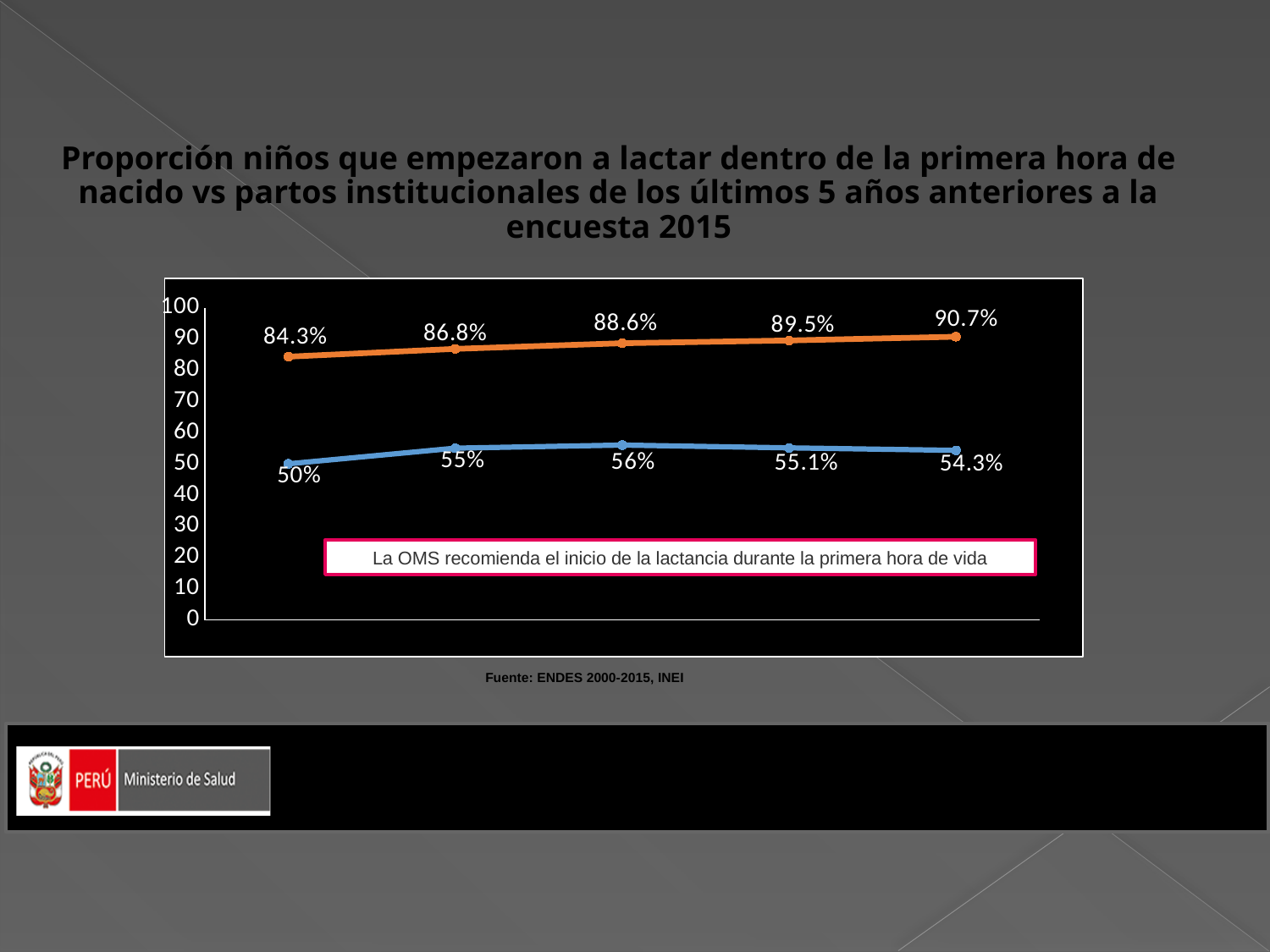
Which is larger, the last value on the orange line or the last value on the blue line? the orange line (90.7%) What is the lowest value on the orange line? 84.3% What type of chart is shown on the slide? line chart How many data points does the orange line have? 5 What is the value of the last point on the orange line? 90.7% What is the value of the first point on the orange line? 84.3% What is the value of the first point on the blue line? 50% Does the orange line rise or fall from left to right? rise What is the difference between the last and first values on the orange line? 6.4% What is the highest value on the blue line? 56% What does the text box inside the chart say? La OMS recomienda el inicio de la lactancia durante la primera hora de vida What is the value of the third point on the blue line? 56%